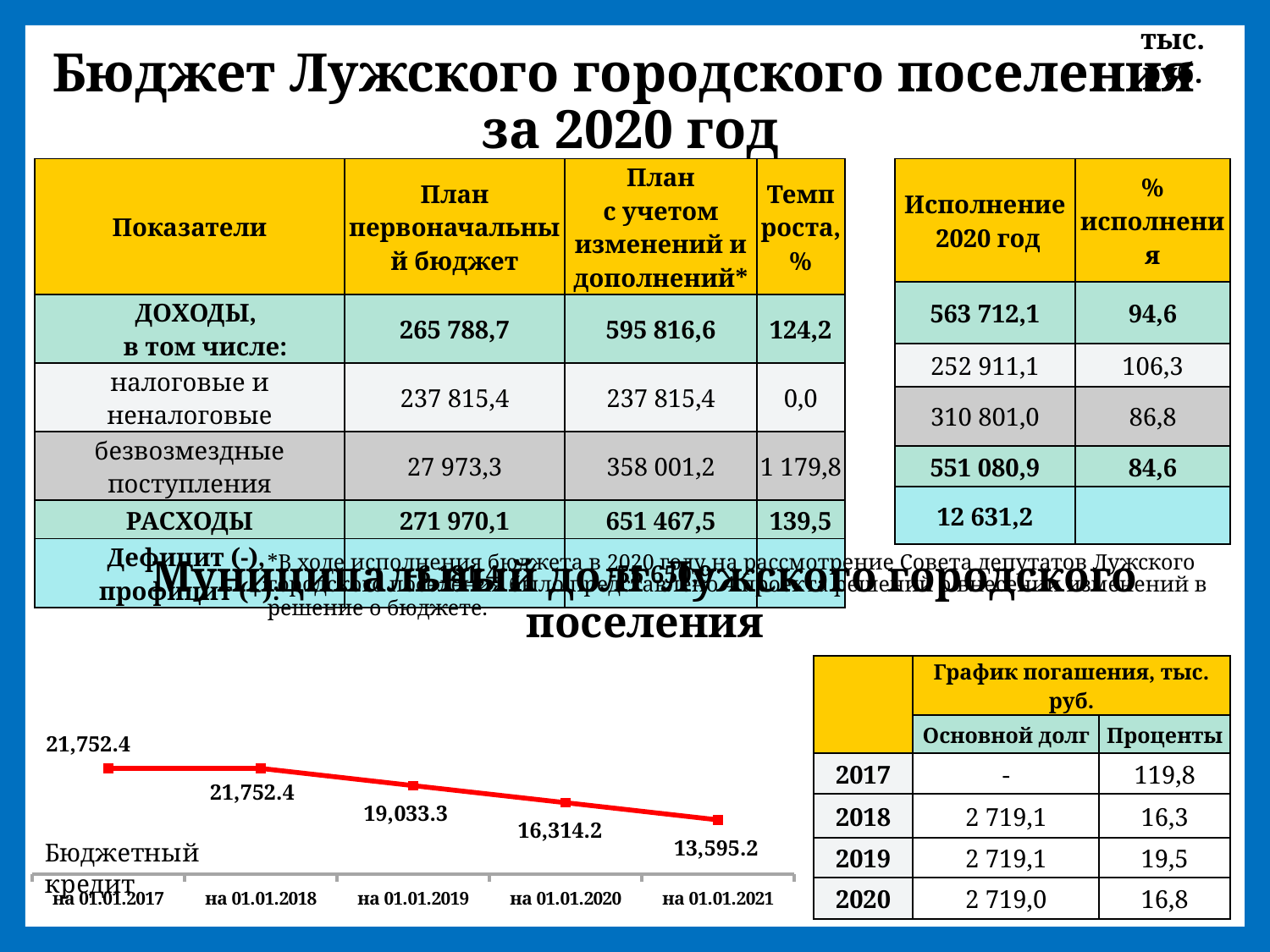
In the line chart, what is the difference between the values for на 01.01.2019 and на 01.01.2020? 2,719.1 In the line chart, what is the difference between the values for на 01.01.2017 and на 01.01.2021? 8,157.2 In the line chart, what is the value for на 01.01.2017? 21,752.4 In the line chart, what is the value for на 01.01.2019? 19,033.3 In the line chart, how many data points are plotted? 5 In the line chart, what is the value for на 01.01.2020? 16,314.2 In the line chart, what is the value for на 01.01.2021? 13,595.2 In the line chart, which date has the lowest value? на 01.01.2021 In the line chart, do the values rise or fall from на 01.01.2018 to на 01.01.2021? fall In the line chart, which is larger: the value for на 01.01.2018 or the value for на 01.01.2021? на 01.01.2018 What type of chart is shown at the bottom left of the slide? line chart